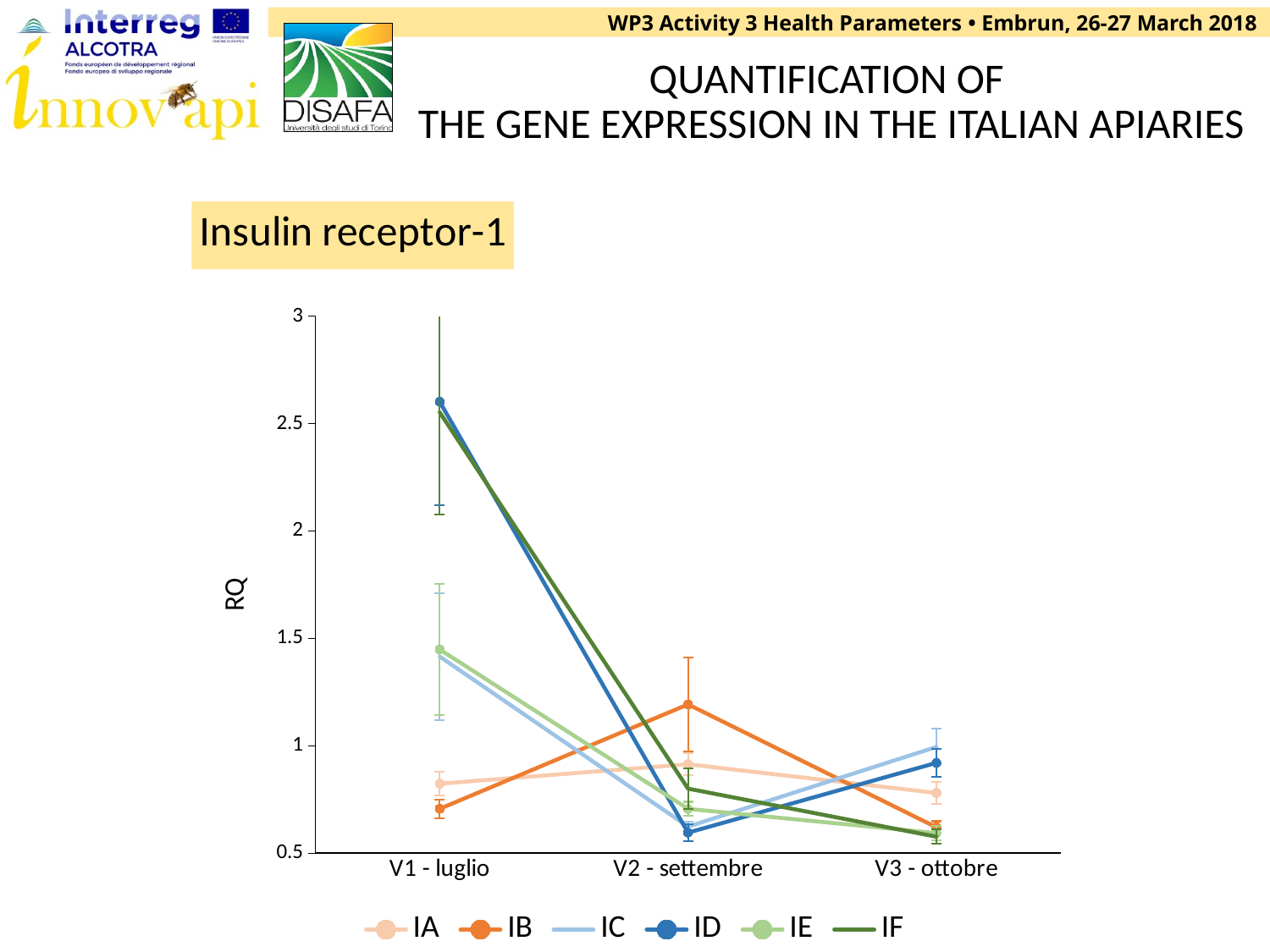
Is the value for ID at V1 - luglio greater or less than 2? greater How many series does the legend list? 6 What is the title of the chart? Insulin receptor-1 How many sampling points are shown on the x axis? 3 What is the label of the y axis? RQ Does the value for ID rise or fall from V1 - luglio to V2 - settembre? fall Is the value for IA at V3 - ottobre greater or less than 1? less Which series has the lowest value at V1 - luglio? IB Which is larger at V1 - luglio, the value for ID or the value for IB? ID What kind of chart is shown on the slide? line chart Is the value for IB at V2 - settembre greater or less than 1? greater Which series has the highest value at V2 - settembre? IB